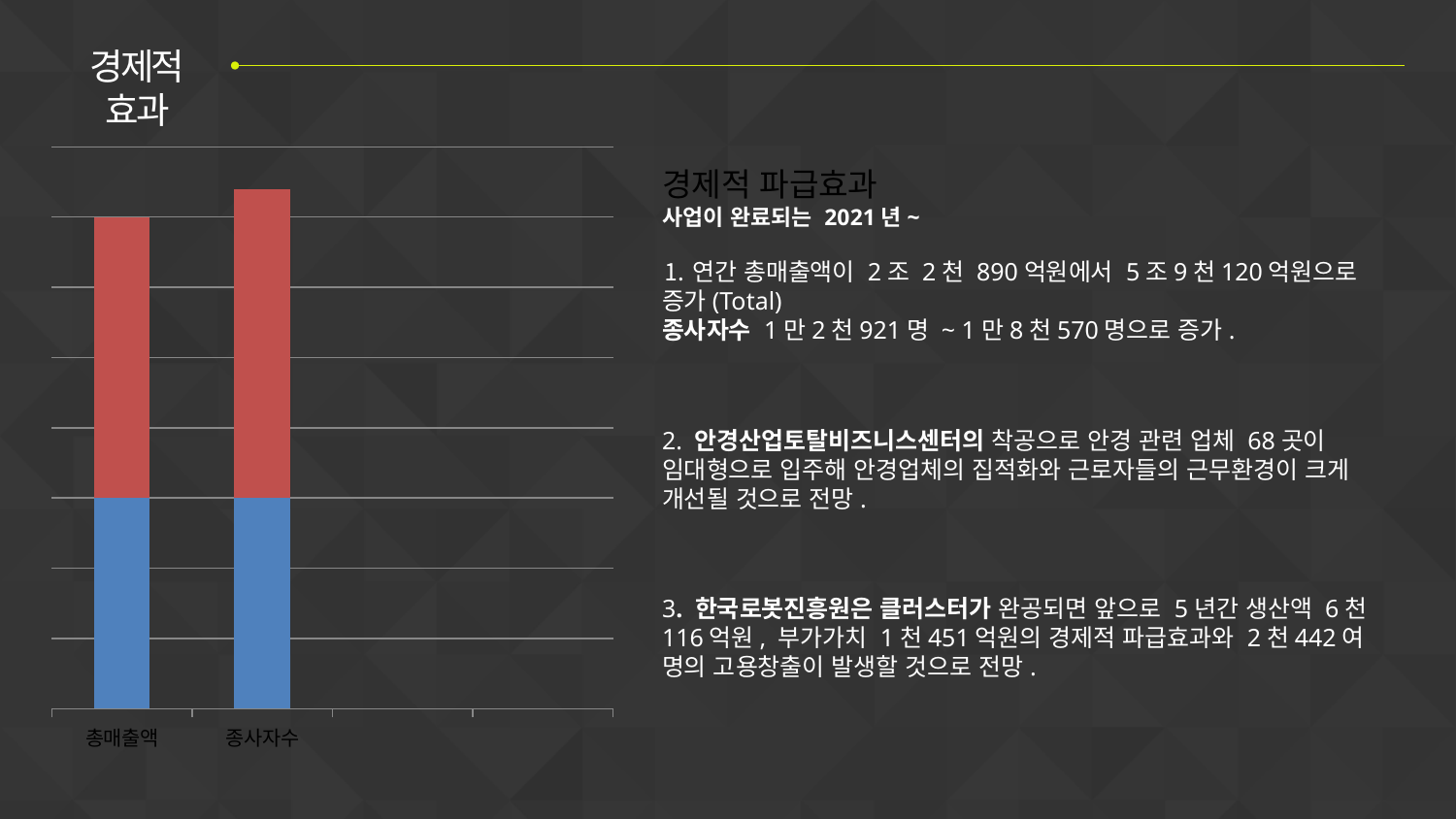
Which category has the shorter stacked bar overall? 총매출액 How many categories are shown on the x axis of the chart? 2 What kind of chart is shown on the left of the slide? Stacked bar chart Which category has the larger red (upper) segment? 종사자수 Is the total bar for 종사자수 taller or shorter than the total bar for 총매출액? taller What two colours are used for the segments of the stacked bars? Blue and red What are the two category labels on the x axis of the chart? 총매출액, 종사자수 Which category has the taller stacked bar overall? 종사자수 How many coloured segments does each stacked bar contain? 2 Do the total bar heights rise or fall from left to right across the x axis? rise